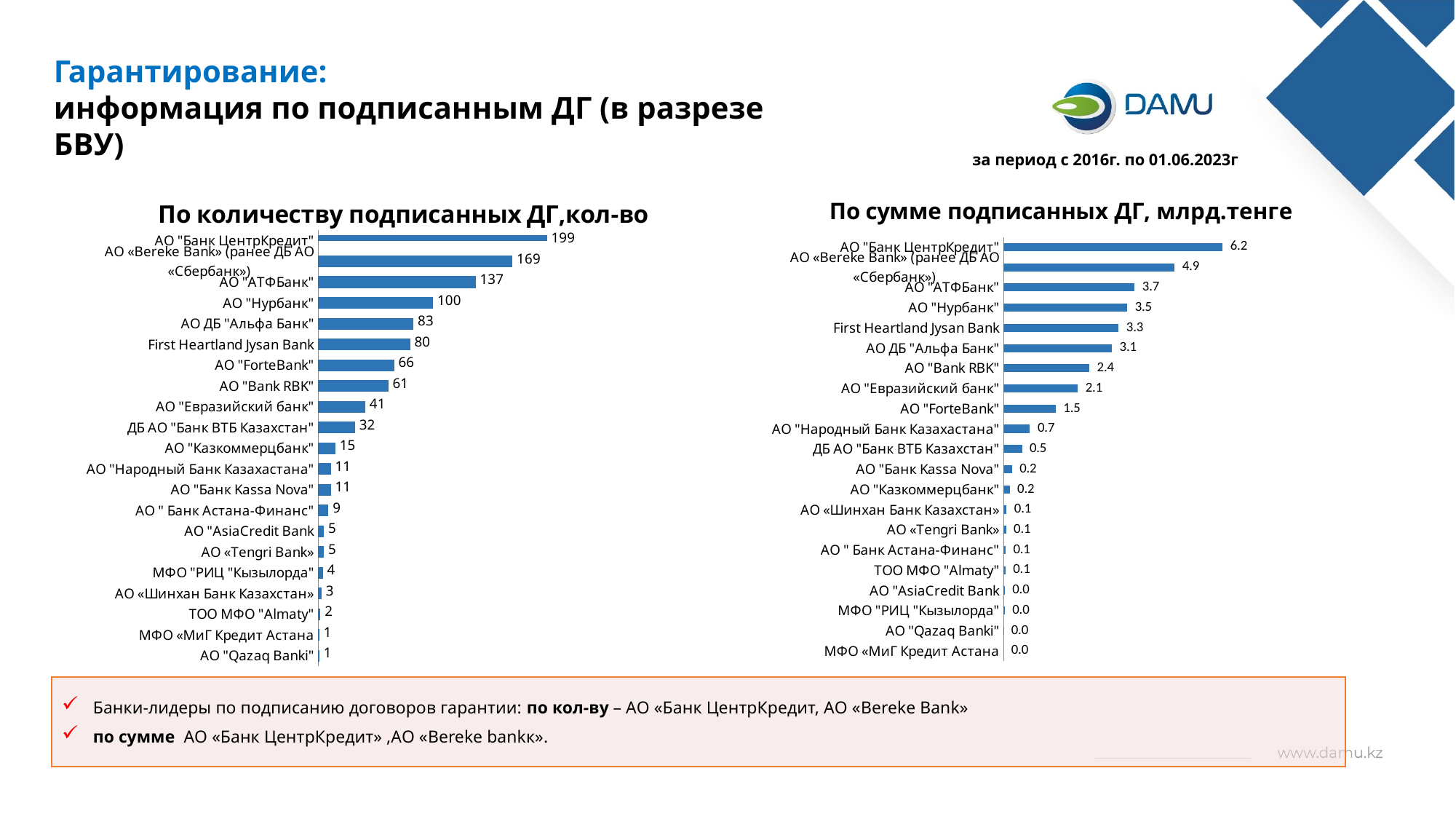
In the chart "По количеству подписанных ДГ,кол-во", which is larger: АО ДБ "Альфа Банк" or АО "ForteBank"? АО ДБ "Альфа Банк" In the chart "По количеству подписанных ДГ,кол-во", what is the value for ДБ АО "Банк ВТБ Казахстан"? 32 In the chart "По сумме подписанных ДГ, млрд.тенге", what is the difference between АО "Банк ЦентрКредит" and АО "Нурбанк"? 2.7 In the chart "По сумме подписанных ДГ, млрд.тенге", what is the value for АО "Народный Банк Казахастана"? 0.7 In the chart "По сумме подписанных ДГ, млрд.тенге", which is larger: АО "Bank RBK" or АО "ForteBank"? АО "Bank RBK" In the chart "По количеству подписанных ДГ,кол-во", what is the difference between АО "Банк ЦентрКредит" and АО «Bereke Bank» (ранее ДБ АО «Сбербанк»)? 30 In the chart "По сумме подписанных ДГ, млрд.тенге", what is the value for First Heartland Jysan Bank? 3.3 How many banks are listed in the chart "По количеству подписанных ДГ,кол-во"? 21 In the chart "По количеству подписанных ДГ,кол-во", what is the value for АО "Нурбанк"? 100 In the chart "По количеству подписанных ДГ,кол-во", which bank has the highest value? АО "Банк ЦентрКредит" What type of chart is "По сумме подписанных ДГ, млрд.тенге"? Bar chart In the chart "По сумме подписанных ДГ, млрд.тенге", what is the value for АО "АТФБанк"? 3.7